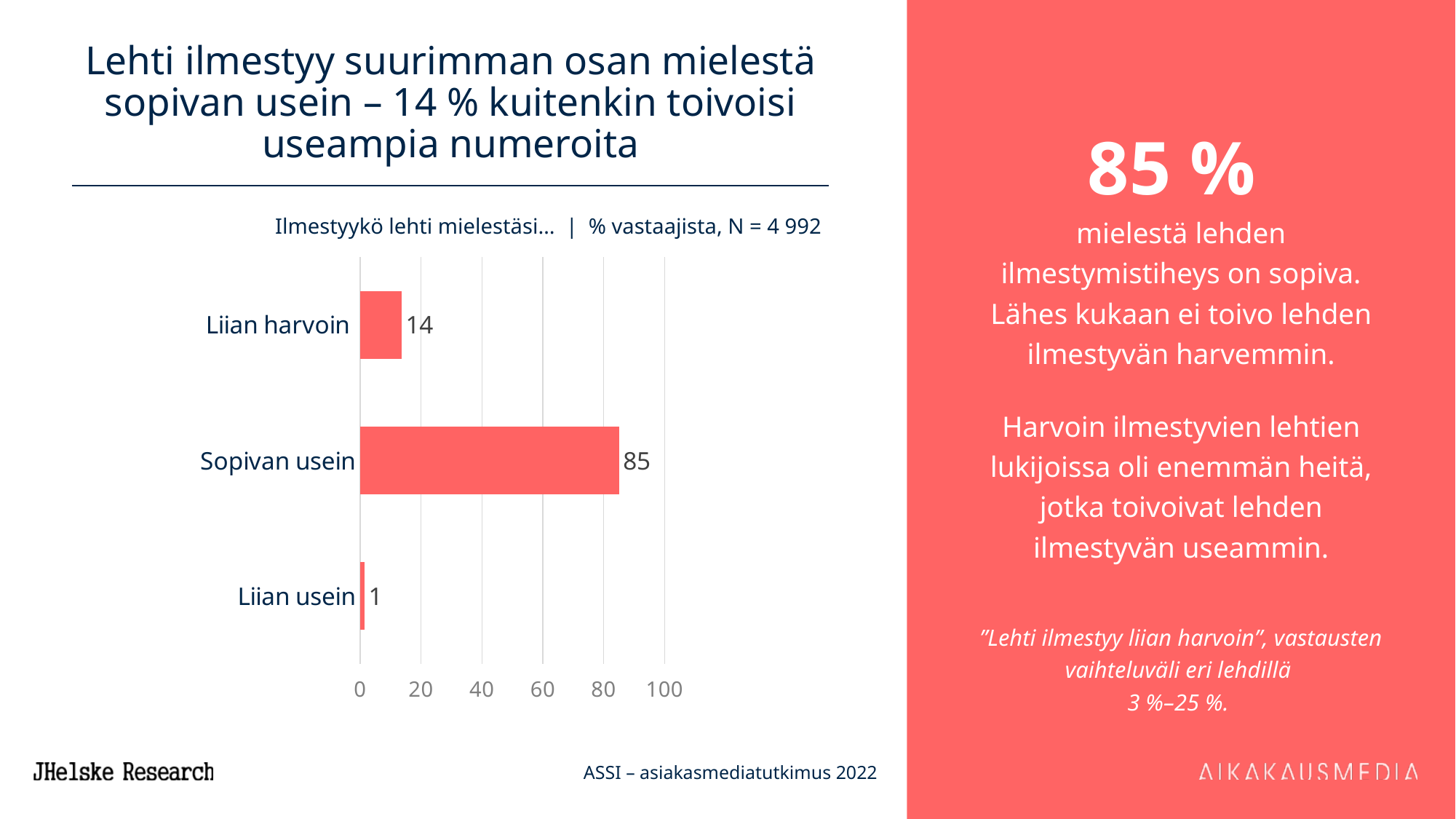
Which category has the highest value? Sopivan usein What is the value for "Liian harvoin"? 14 Is the value for "Sopivan usein" greater or less than 80? greater What kind of chart is shown on the slide? bar chart What is the difference between the values for "Sopivan usein" and "Liian harvoin"? 71 What is the highest tick value shown on the x axis? 100 What is the value for "Liian usein"? 1 What is the sample size (N) stated in the chart subtitle? 4 992 Which is larger, the value for "Liian harvoin" or the value for "Liian usein"? Liian harvoin Which category has the lowest value? Liian usein What is the value for "Sopivan usein"? 85 How many categories are shown in the chart? 3